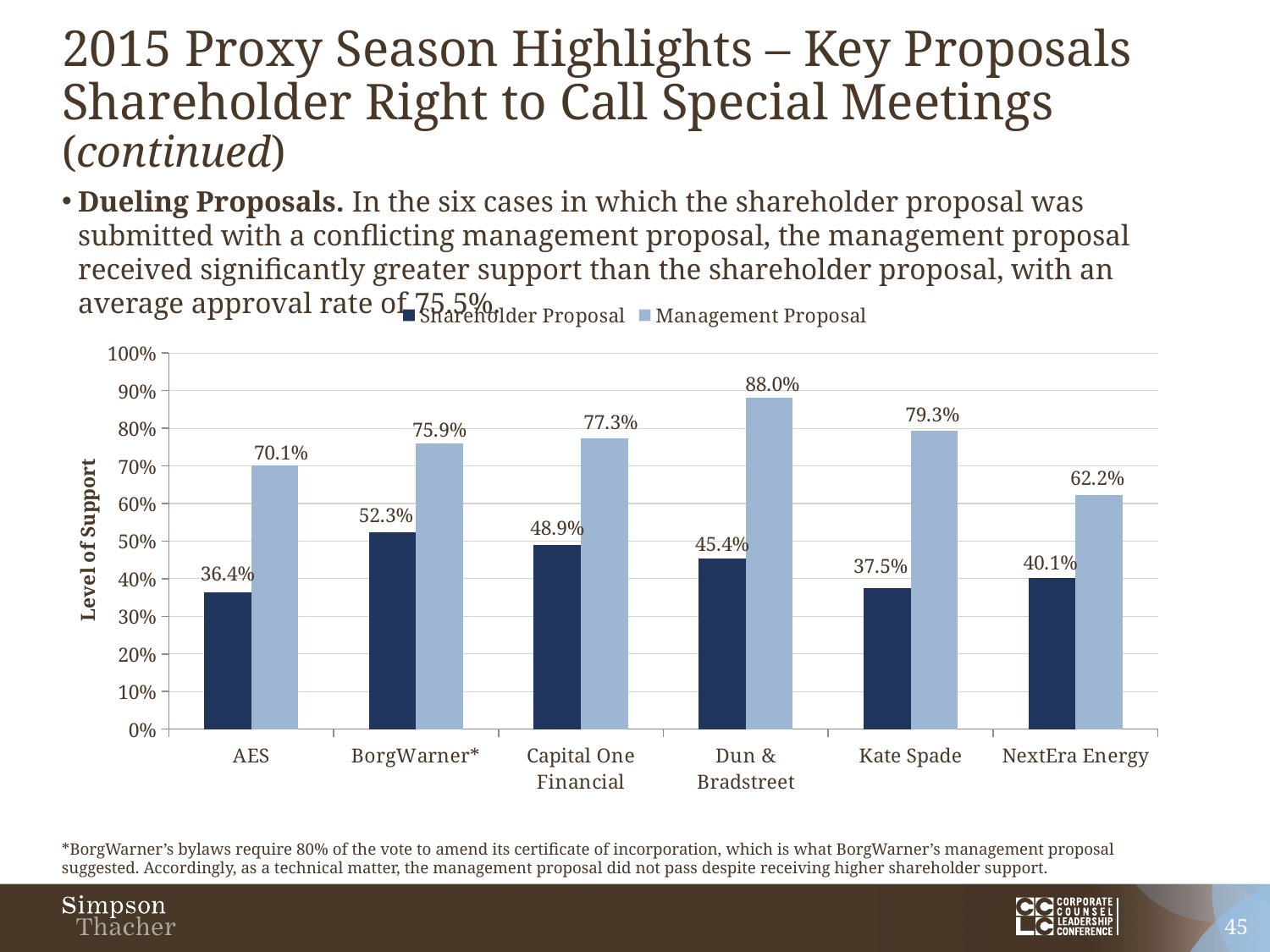
What is the label of the vertical axis of the chart? Level of Support How many series does the chart legend list? 2 Is the Management Proposal support for NextEra Energy greater or less than 70%? less Which company has the highest Shareholder Proposal level of support? BorgWarner* What is the Management Proposal level of support for Dun & Bradstreet? 88.0% What is the difference between the Management Proposal and Shareholder Proposal support at Kate Spade? 41.8% How many companies are shown on the x axis of the chart? 6 Which is larger: the Shareholder Proposal support at BorgWarner* or at Capital One Financial? BorgWarner* Which company has the highest Management Proposal level of support? Dun & Bradstreet What is the Shareholder Proposal level of support for AES? 36.4% What kind of chart is shown on the slide? bar chart Which company has the lowest Shareholder Proposal level of support? AES